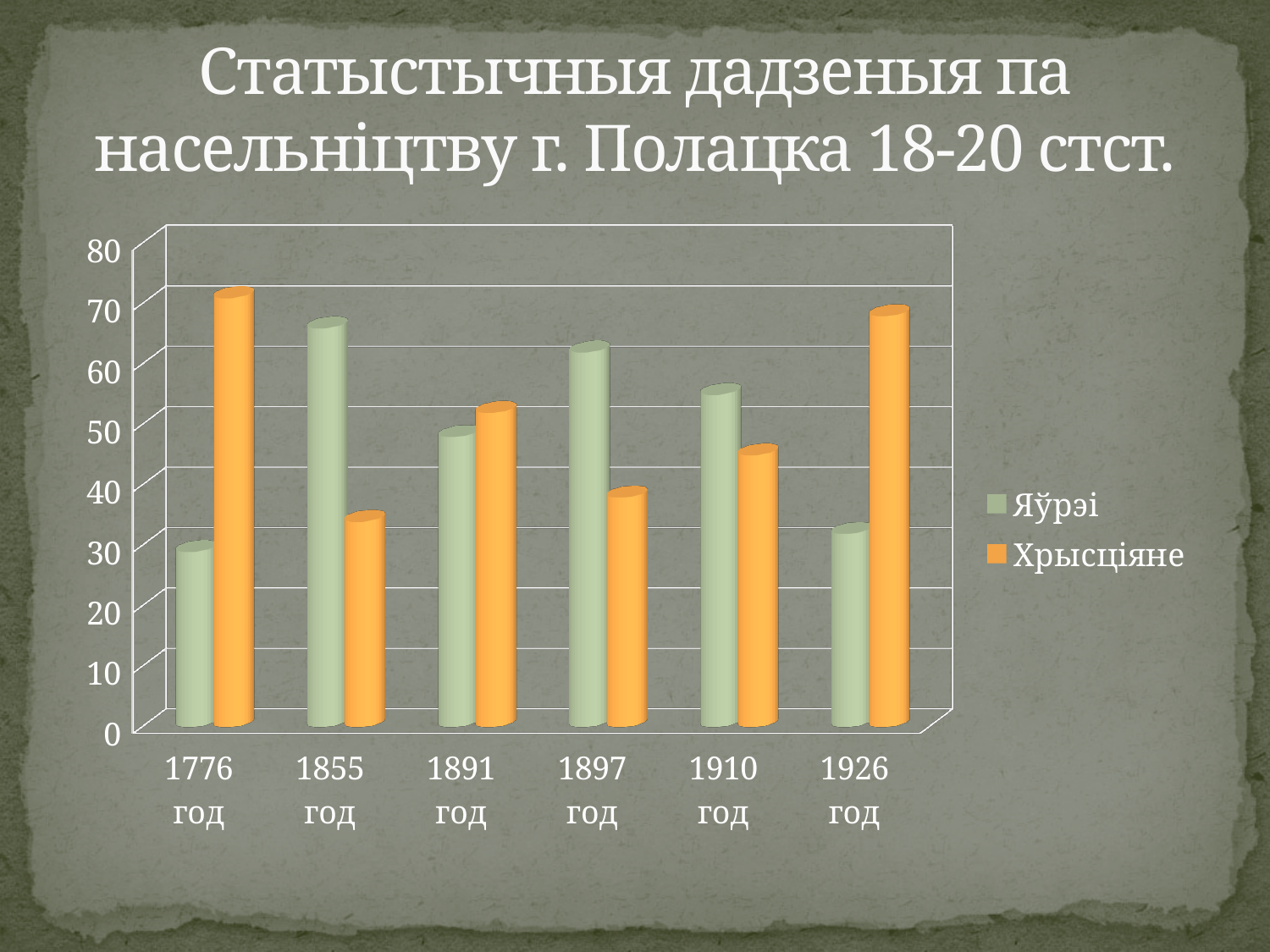
In 1926 год, which series has the larger value, Яўрэі or Хрысціяне? Хрысціяне How many year categories are shown on the x axis of the chart? 6 Which colour represents the Хрысціяне series in the chart? orange In 1855 год, which series has the larger value, Яўрэі or Хрысціяне? Яўрэі Is the value for Яўрэі in 1776 год greater or less than 40? less What are the two series named in the chart's legend? Яўрэі and Хрысціяне Is the value for Хрысціяне in 1926 год greater or less than 60? greater Is the value for Хрысціяне in 1776 год greater or less than 60? greater How many series does the chart's legend list? 2 What kind of chart is shown on the slide? bar chart